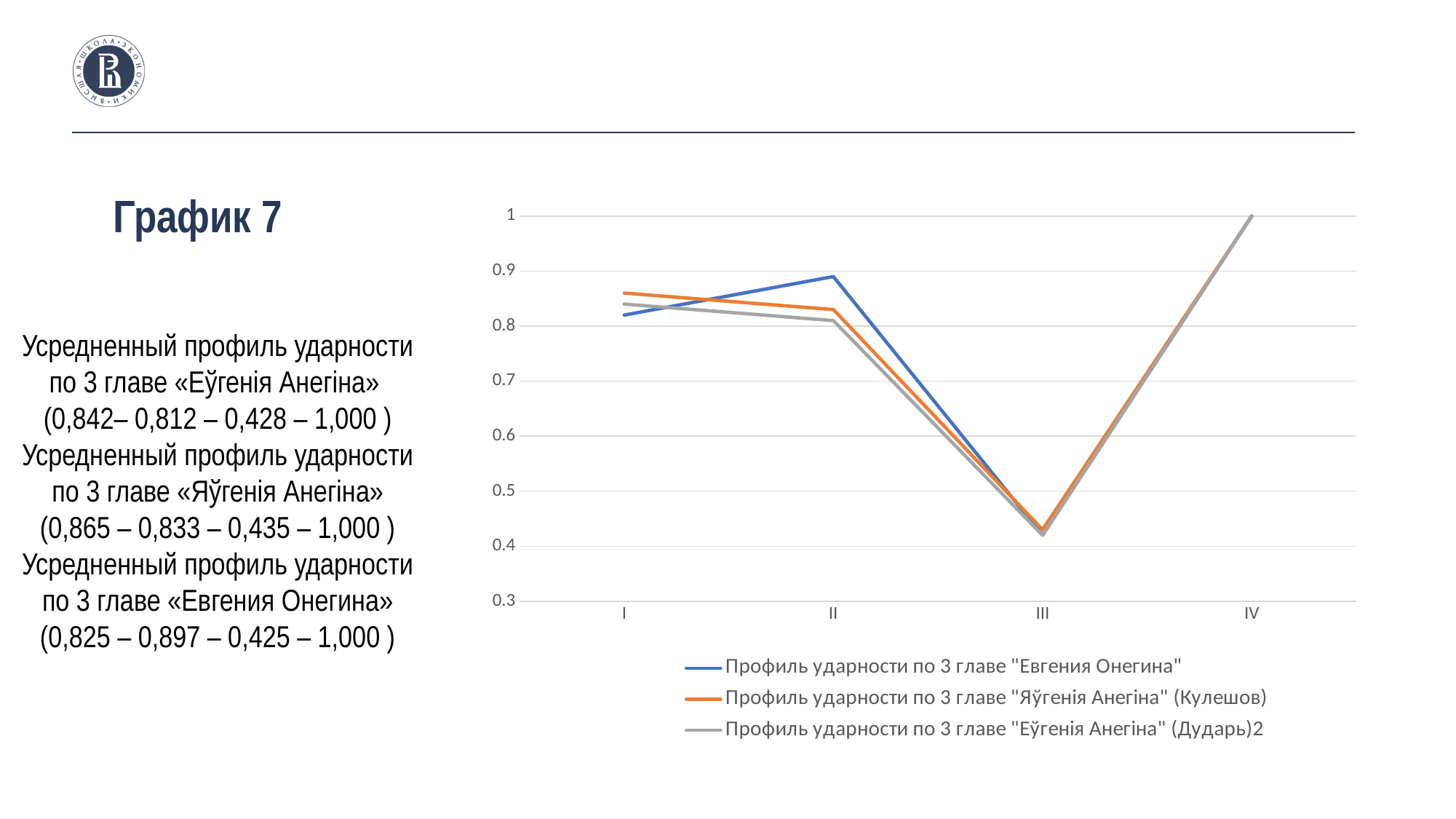
Do the values of the series rise or fall from category II to category III? fall What colour is the line for the series 'Профиль ударности по 3 главе "Евгения Онегина"'? blue What kind of chart is shown on the slide? line chart Is the value of the series 'Профиль ударности по 3 главе "Евгения Онегина"' at category II greater or less than 0.8? greater How many series does the chart legend list? 3 At category II, which series has the larger value: 'Профиль ударности по 3 главе "Евгения Онегина"' or 'Профиль ударности по 3 главе "Яўгенія Анегіна" (Кулешов)'? Профиль ударности по 3 главе "Евгения Онегина" How many categories are shown on the x axis of the chart? 4 Is the value of the series 'Профиль ударности по 3 главе "Еўгенія Анегіна" (Дударь)2' at category III greater or less than 0.5? less At which category is the series 'Профиль ударности по 3 главе "Евгения Онегина"' lowest? III What value do all three series reach at category IV? 1 At which category is the series 'Профиль ударности по 3 главе "Яўгенія Анегіна" (Кулешов)' highest? IV What is the title given to the chart on the slide? График 7